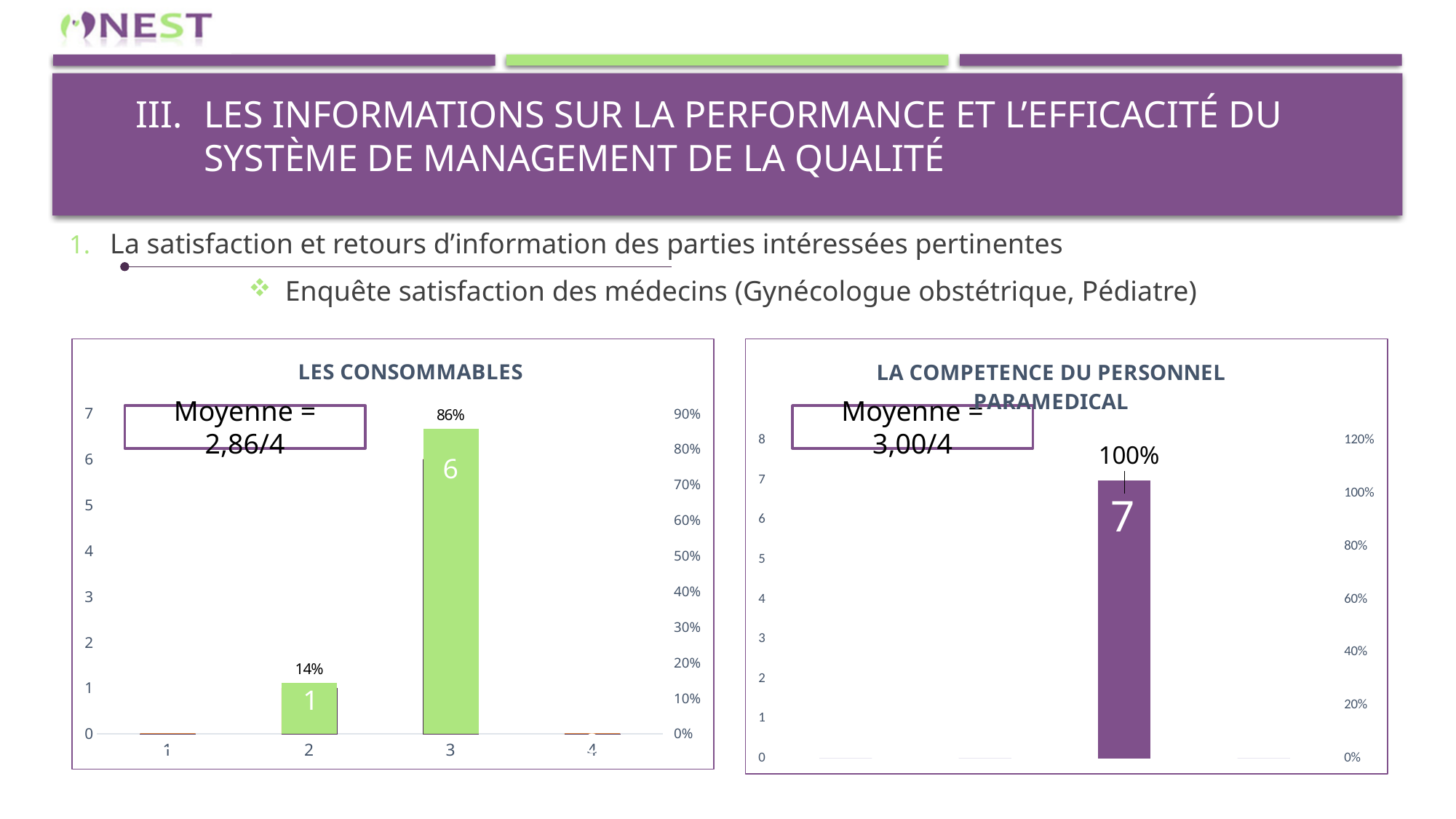
In the chart titled LES CONSOMMABLES, which has a larger count, category 2 or category 3? 3 In the chart titled LES CONSOMMABLES, what is the count shown for category 2? 1 In the chart titled LES CONSOMMABLES, how many categories are shown on the x axis? 4 In the chart titled LA COMPETENCE DU PERSONNEL PARAMEDICAL, what percentage is printed above the bar? 100% In the chart titled LES CONSOMMABLES, what is the count shown for category 3? 6 In the chart titled LES CONSOMMABLES, what percentage is shown above the bar for category 2? 14% In the chart titled LA COMPETENCE DU PERSONNEL PARAMEDICAL, what count is printed on the bar? 7 In the chart titled LES CONSOMMABLES, which category has the highest count? 3 In the chart titled LES CONSOMMABLES, what is the difference between the counts for category 3 and category 2? 5 In the chart titled LES CONSOMMABLES, what percentage is shown above the bar for category 3? 86% What average (Moyenne) is shown in the box on the chart titled LES CONSOMMABLES? 2,86/4 What type of chart is the chart titled LES CONSOMMABLES? bar chart